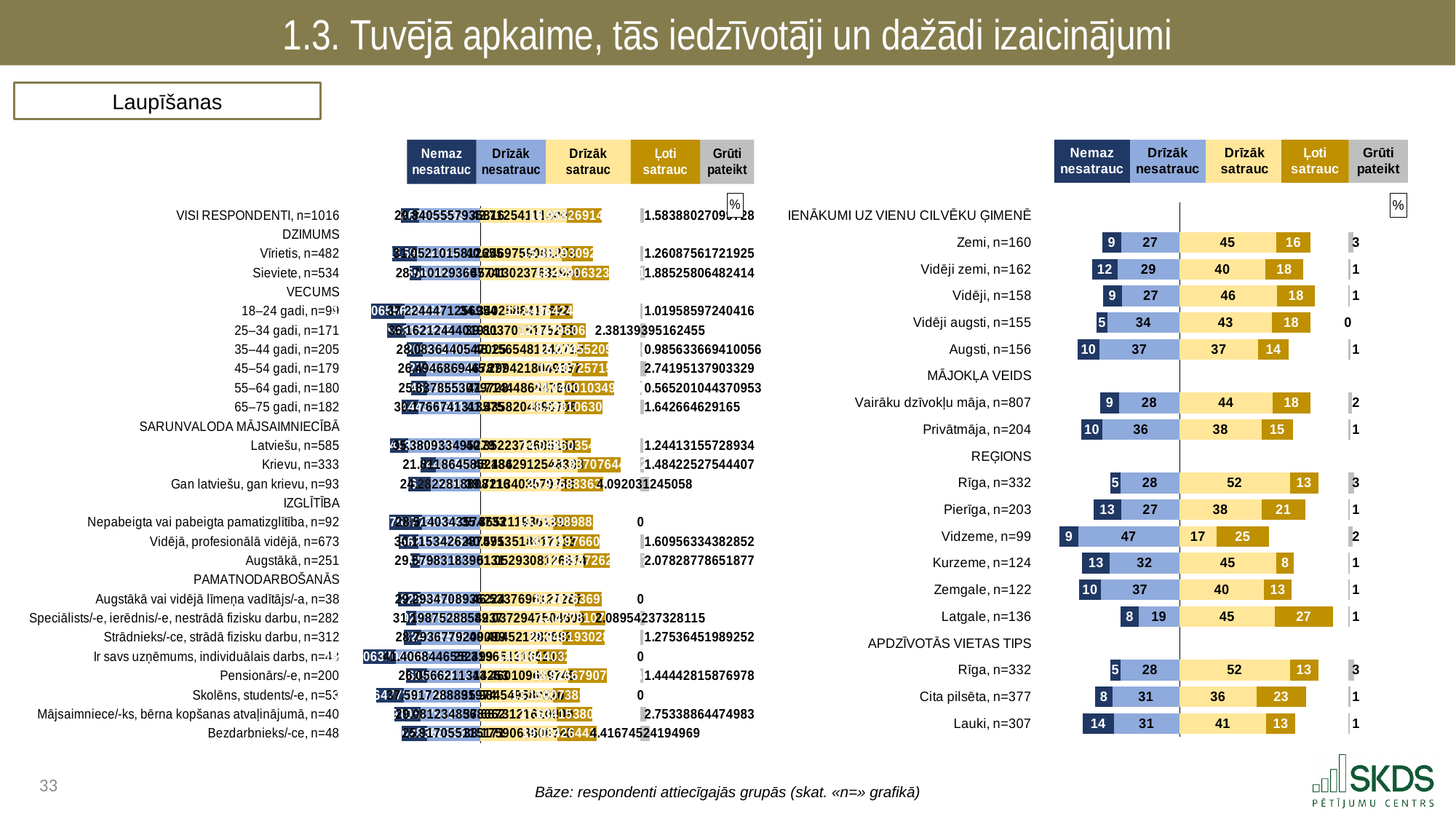
In the right-hand chart, which region under REĢIONS has the highest "Ļoti satrauc" value? Latgale, n=136 In the right-hand chart, what is the value of "Ļoti satrauc" for Latgale, n=136? 27 In the right-hand chart, what is the value of "Drīzāk satrauc" for Zemi, n=160? 45 In the right-hand chart, which is larger: the "Drīzāk nesatrauc" value for Augsti, n=156 or for Zemi, n=160? Augsti, n=156 In the right-hand chart, what is the total of the "Drīzāk satrauc" and "Ļoti satrauc" values for Privātmāja, n=204? 53 What kind of chart is the right-hand chart? Stacked bar chart In the right-hand chart, what is the value of "Nemaz nesatrauc" for Lauki, n=307? 14 In the right-hand chart, what is the value of "Grūti pateikt" for Vidēji augsti, n=155? 0 In the right-hand chart, which region under REĢIONS has the lowest "Ļoti satrauc" value? Kurzeme, n=124 In the right-hand chart, what is the value of "Drīzāk nesatrauc" for Vidzeme, n=99? 47 How many series does the legend of the right-hand chart list? 5 In the right-hand chart, what is the difference between the "Drīzāk satrauc" values for Rīga, n=332 and Pierīga, n=203 under REĢIONS? 14